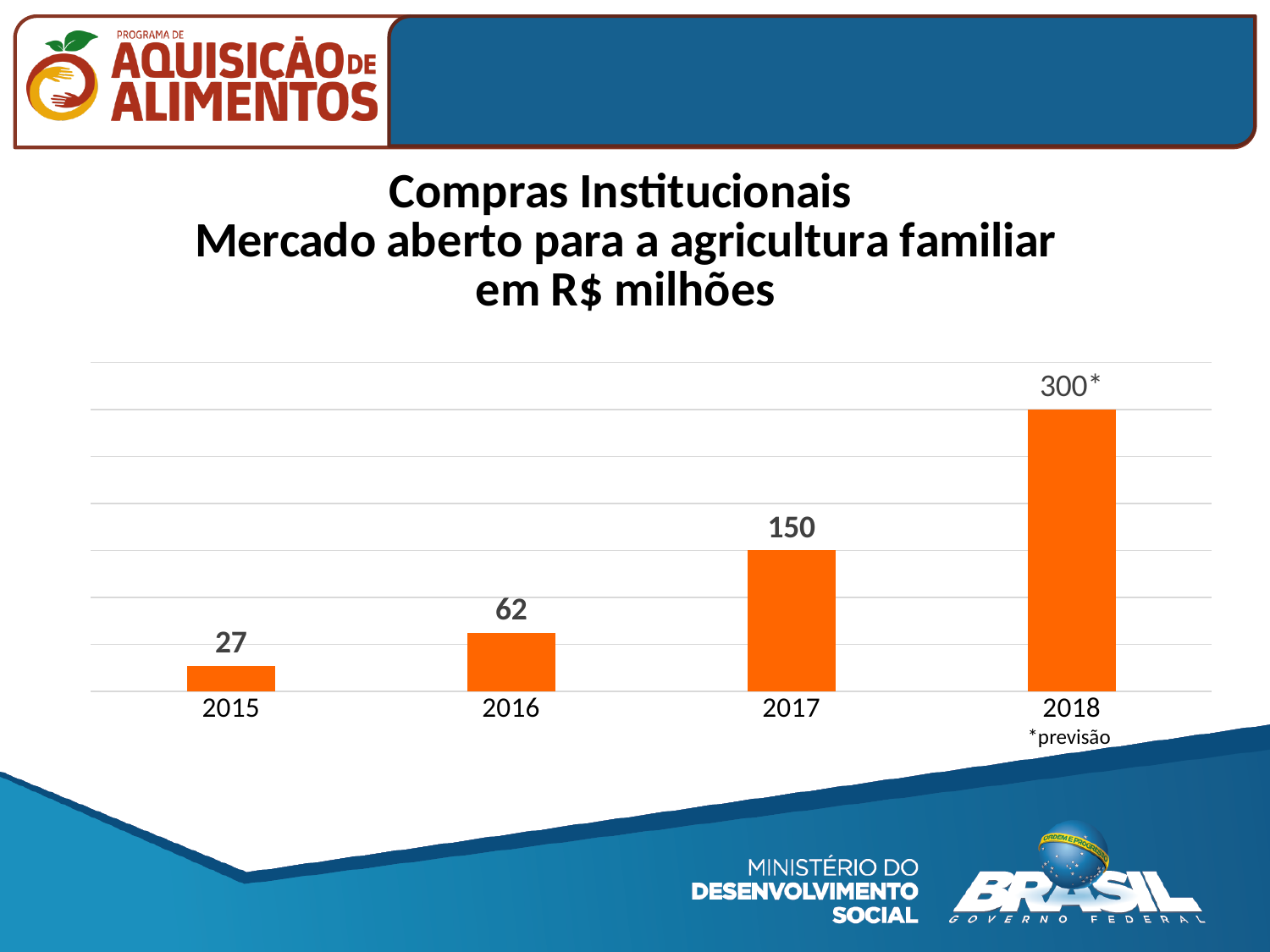
What is the value for 2015? 27 What is the difference between the values for 2017 and 2016? 88 How many years are shown on the x axis? 4 Which year has the lowest value? 2015 What is the value for 2017? 150 What does the asterisk on the 2018 value indicate, according to the note below the chart? previsão What is the value for 2016? 62 Which year has the highest value? 2018 Do the values rise or fall from 2015 to 2018? rise Which is larger, the value for 2016 or the value for 2015? 2016 What is the value labelled for 2018? 300* What kind of chart is this? bar chart